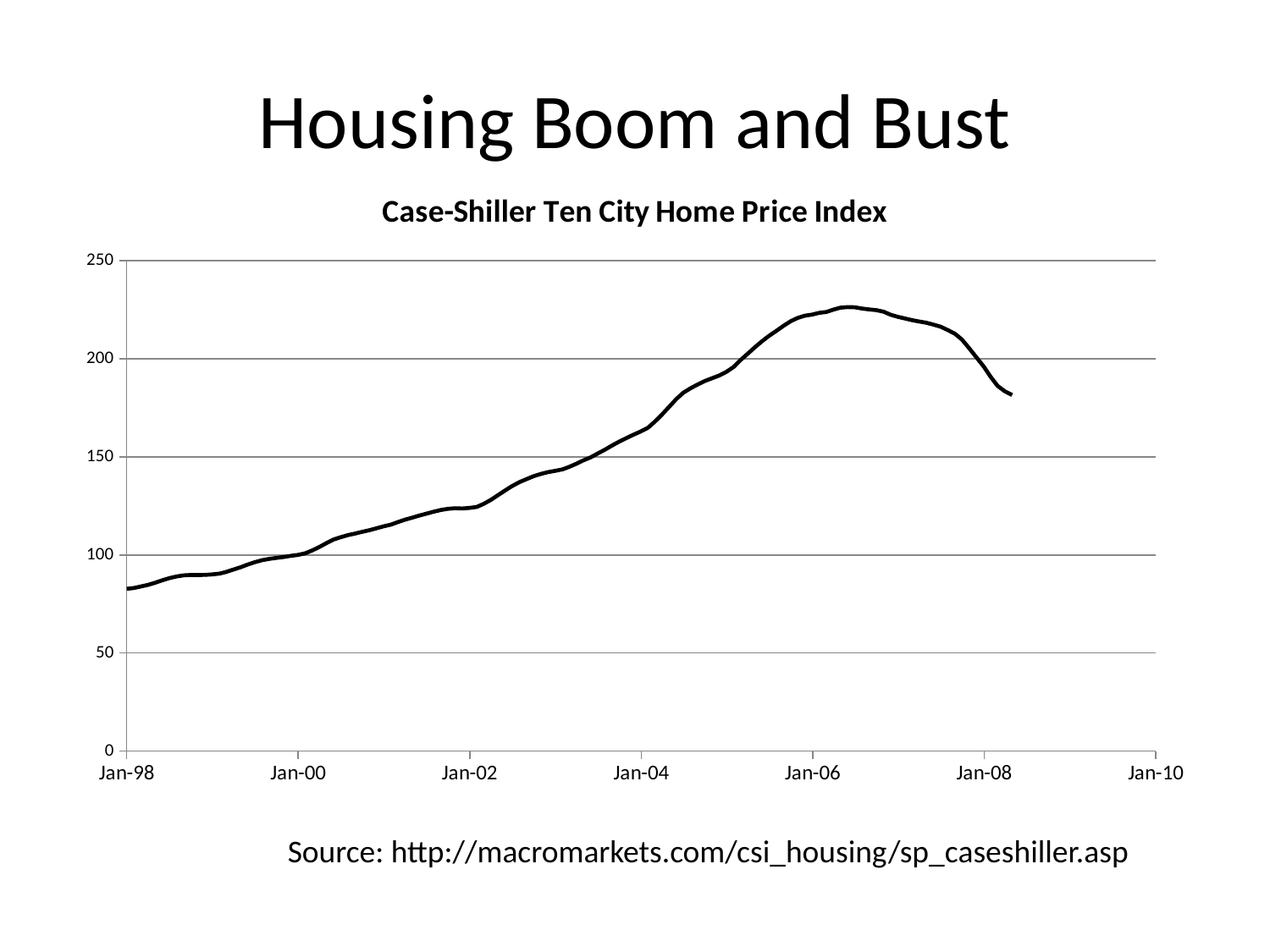
Is the value for Jan-02 greater or less than 100? greater Does the index rise or fall between Jan-98 and Jan-06? rise Which is larger, the value at Jan-04 or the value at Jan-00? Jan-04 How many lines are plotted on the chart? 1 What kind of chart is shown on the slide? line chart Is the value for Jan-04 greater or less than 150? greater Is the value for Jan-02 greater or less than 150? less Does the index rise or fall after its peak in 2006? fall What is the title of the chart? Case-Shiller Ten City Home Price Index